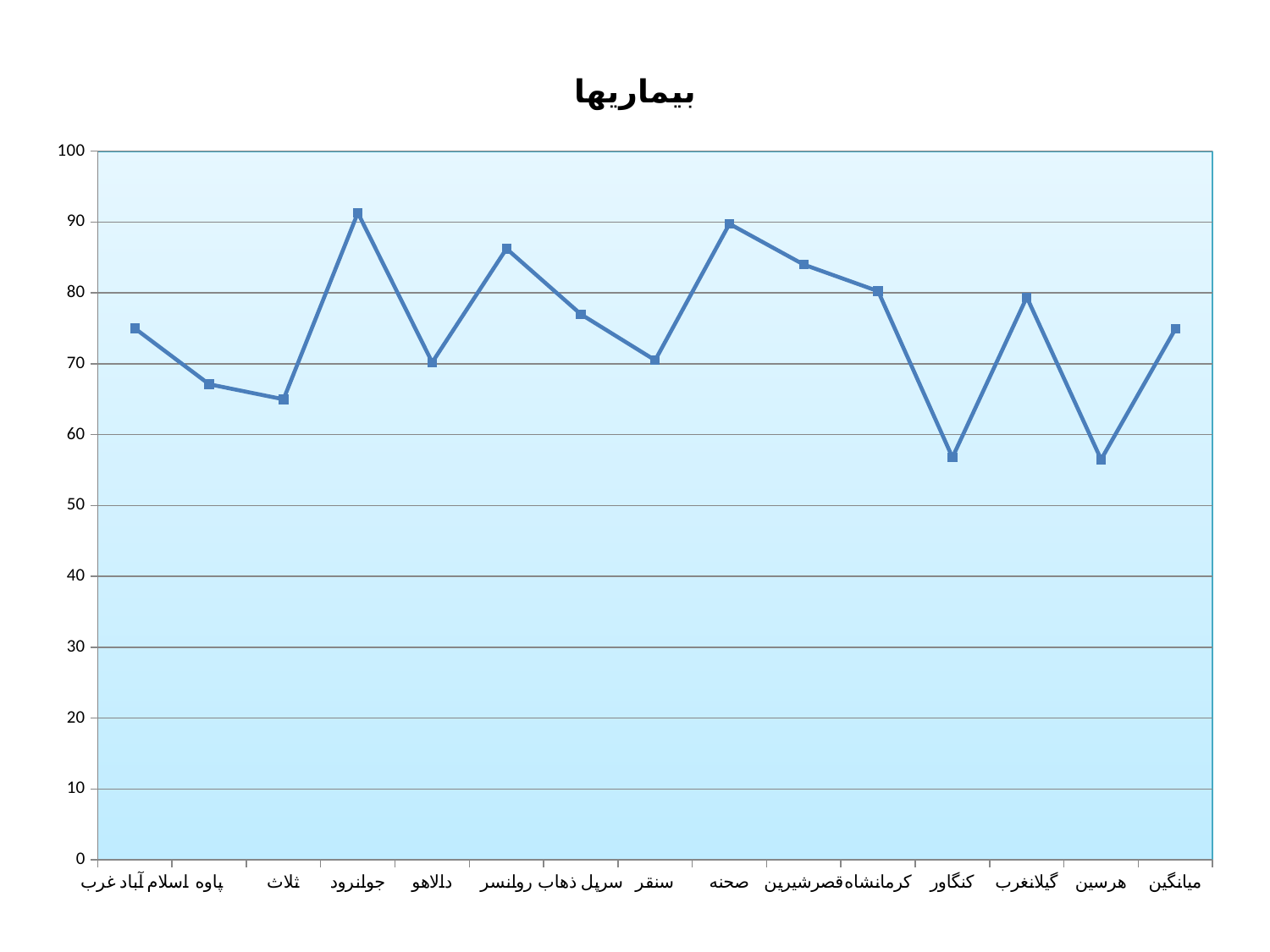
Which has a larger value, کنگاور or گیلانغرب? گیلانغرب How many categories are plotted along the x axis? 15 Which category has the highest value? جوانرود Which has a larger value, روانسر or دالاهو? روانسر Is the value for روانسر greater or less than 80? greater Is the value for هرسین greater or less than 60? less Is the value for کنگاور greater or less than 60? less What kind of chart is shown on the slide? line chart What is the title of the chart? بیماریها Does the line rise or fall from کرمانشاه to کنگاور? fall